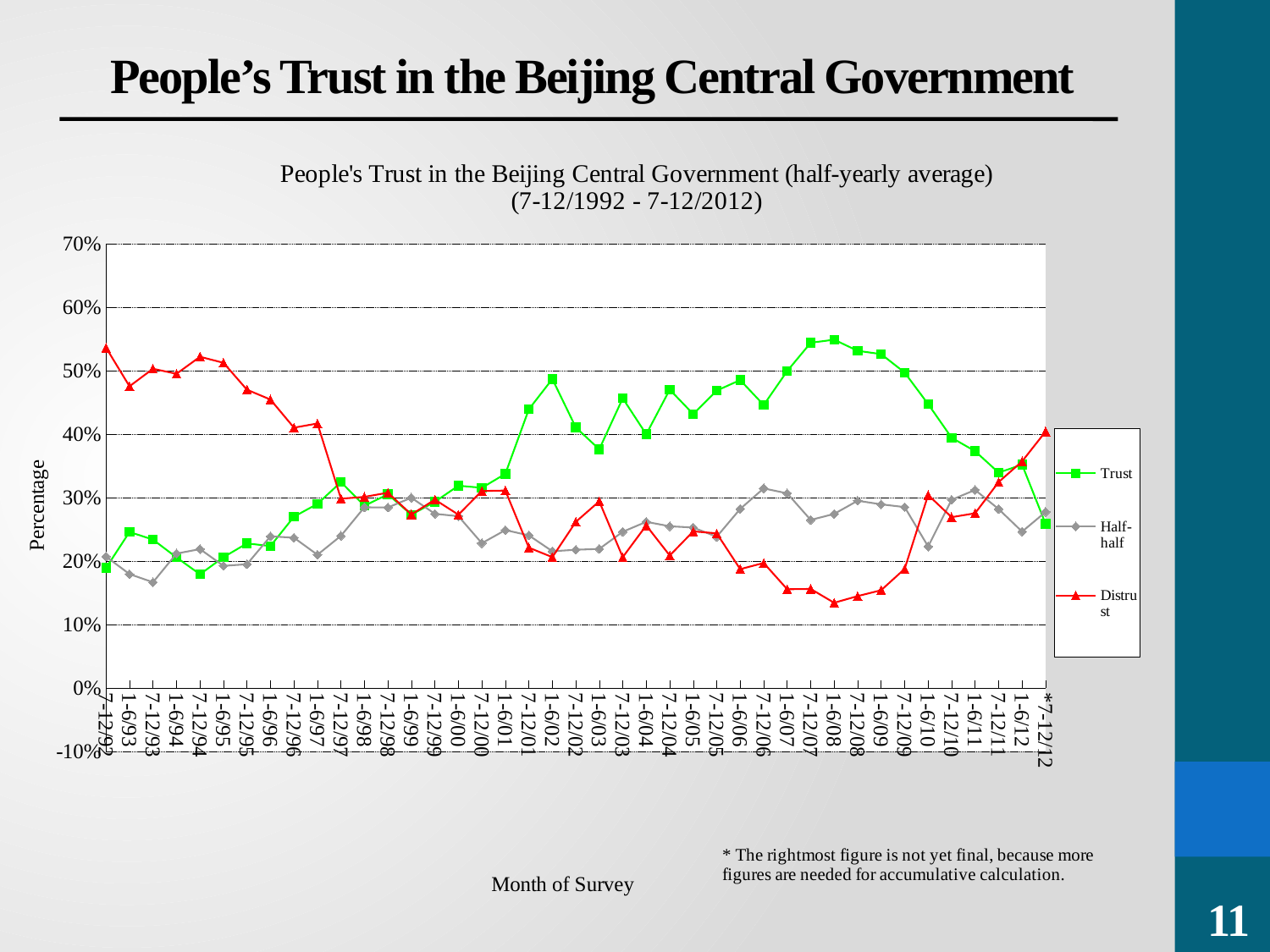
Is the value for Trust at 7-12/92 greater or less than 20%? less What kind of chart is shown on the slide? Line chart Is the value for Trust at 1-6/08 greater or less than 50%? greater Does the Trust line rise or fall between 1-6/08 and *7-12/12? Fall Which series reaches the highest value anywhere on the chart? Trust Is the value for Distrust at 7-12/92 greater or less than 50%? greater At 7-12/92, which is larger: Trust or Distrust? Distrust At *7-12/12, which is larger: Trust or Distrust? Distrust How many series does the legend list? 3 What are the three series named in the legend? Trust, Half-half, Distrust What is the label on the x axis of the chart? Month of Survey